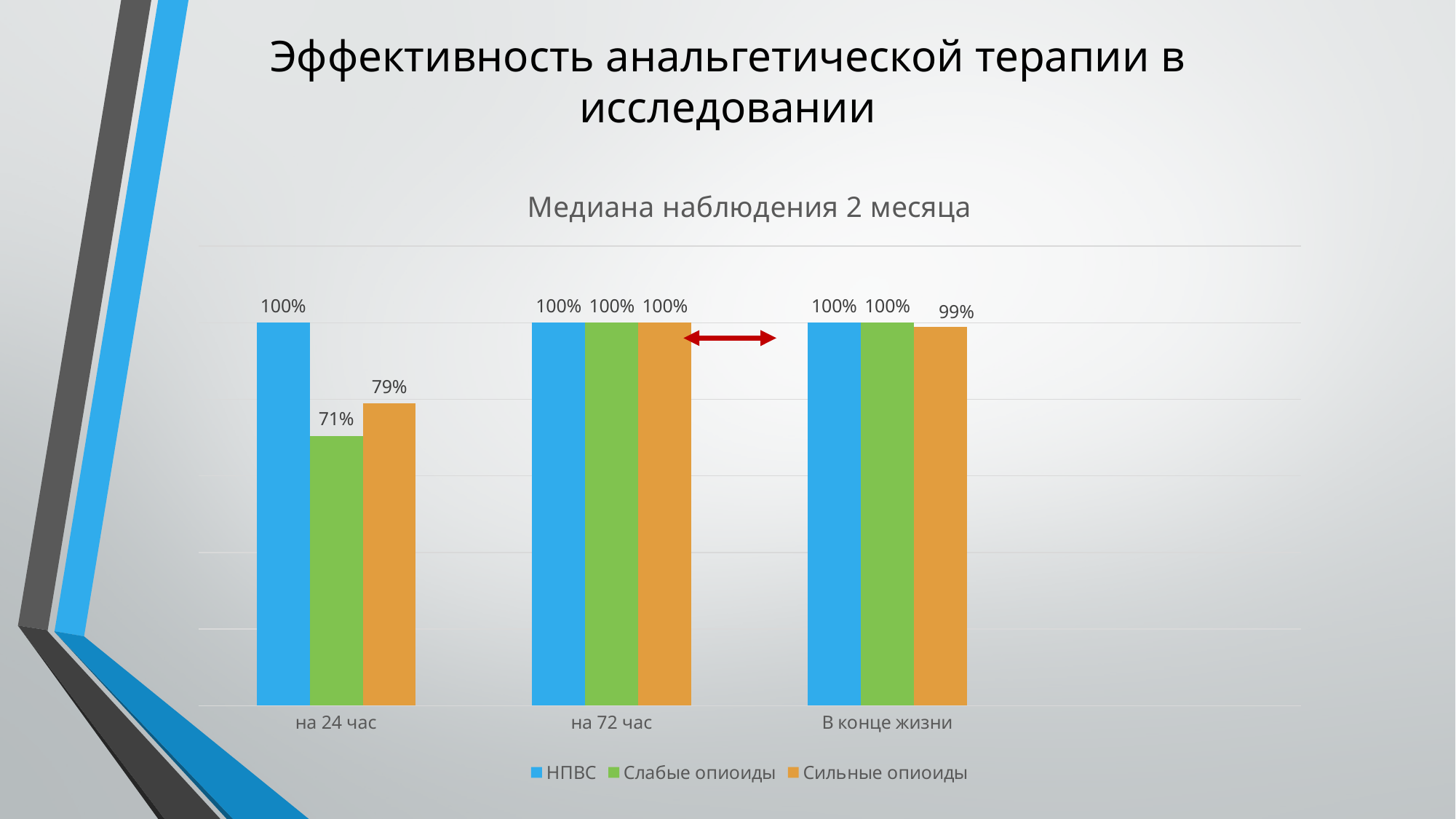
What is the difference between the НПВС and Слабые опиоиды values at на 24 час? 29% What is the value for Сильные опиоиды at на 24 час? 79% Which series has the lowest value at на 24 час? Слабые опиоиды What is the title of the chart? Медиана наблюдения 2 месяца What is the value for Сильные опиоиды at В конце жизни? 99% How many categories are shown on the x axis? 3 What is the value for НПВС at на 72 час? 100% What kind of chart is shown? Bar chart At на 24 час, which is larger: Слабые опиоиды or Сильные опиоиды? Сильные опиоиды What is the difference between the Сильные опиоиды and Слабые опиоиды values at на 24 час? 8% What is the value for Слабые опиоиды at на 24 час? 71% How many series does the legend list? 3